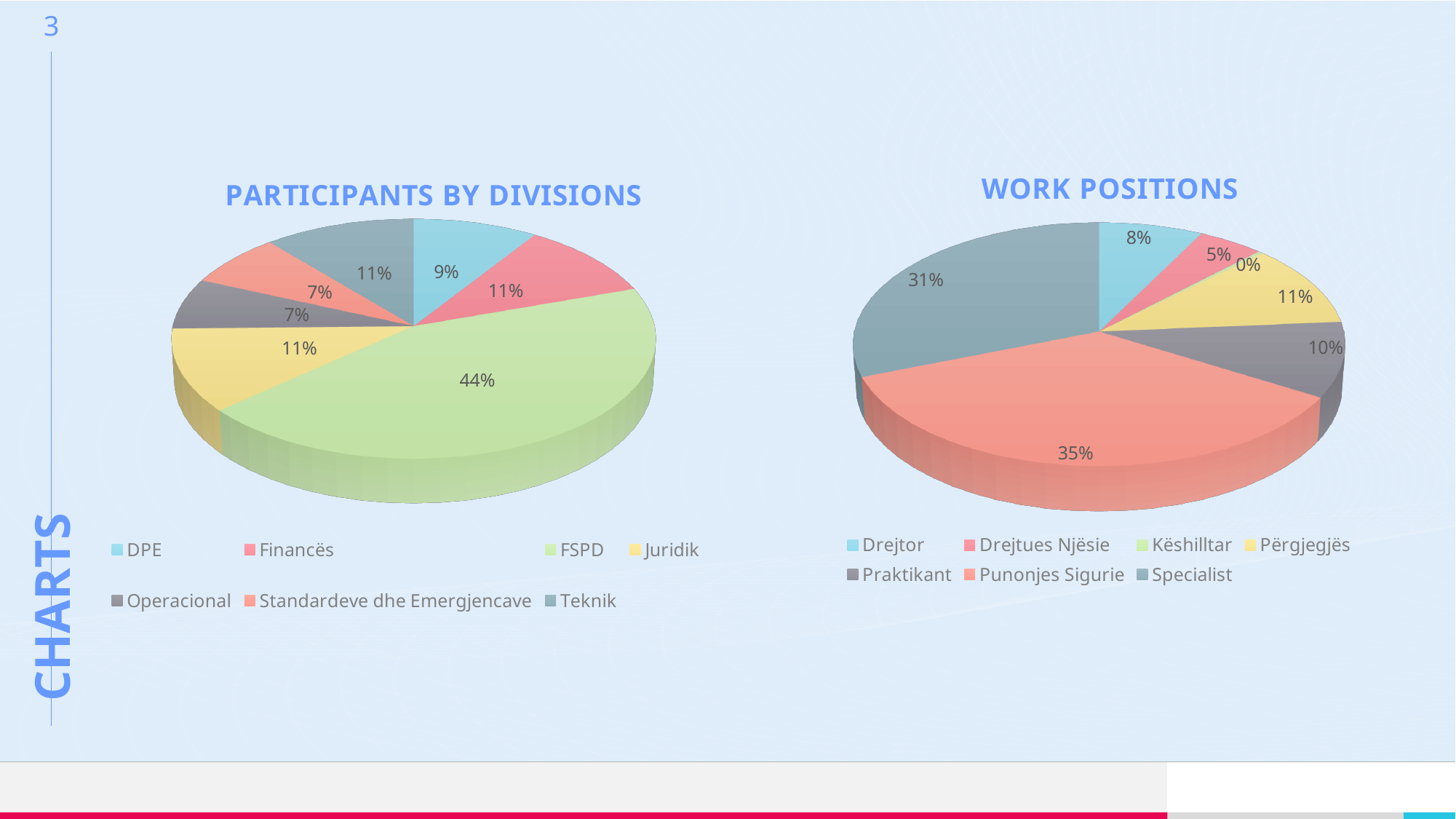
In the PARTICIPANTS BY DIVISIONS chart, what is the difference between the FSPD share and the Juridik share? 33% In the WORK POSITIONS chart, which is larger, Praktikant or Përgjegjës? Përgjegjës What type of chart is the PARTICIPANTS BY DIVISIONS chart? Pie chart In the WORK POSITIONS chart, which work position has the smallest share? Këshilltar In the PARTICIPANTS BY DIVISIONS chart, how many divisions are shown in the legend? 7 In the WORK POSITIONS chart, what share is Punonjes Sigurie? 35% In the WORK POSITIONS chart, what is the difference between the Punonjes Sigurie share and the Specialist share? 4% In the PARTICIPANTS BY DIVISIONS chart, what share of participants is from FSPD? 44% In the WORK POSITIONS chart, what colour is the Drejtor slice? Light blue In the PARTICIPANTS BY DIVISIONS chart, what share of participants is from DPE? 9% In the WORK POSITIONS chart, what share is Specialist? 31% In the PARTICIPANTS BY DIVISIONS chart, which division has the largest share? FSPD